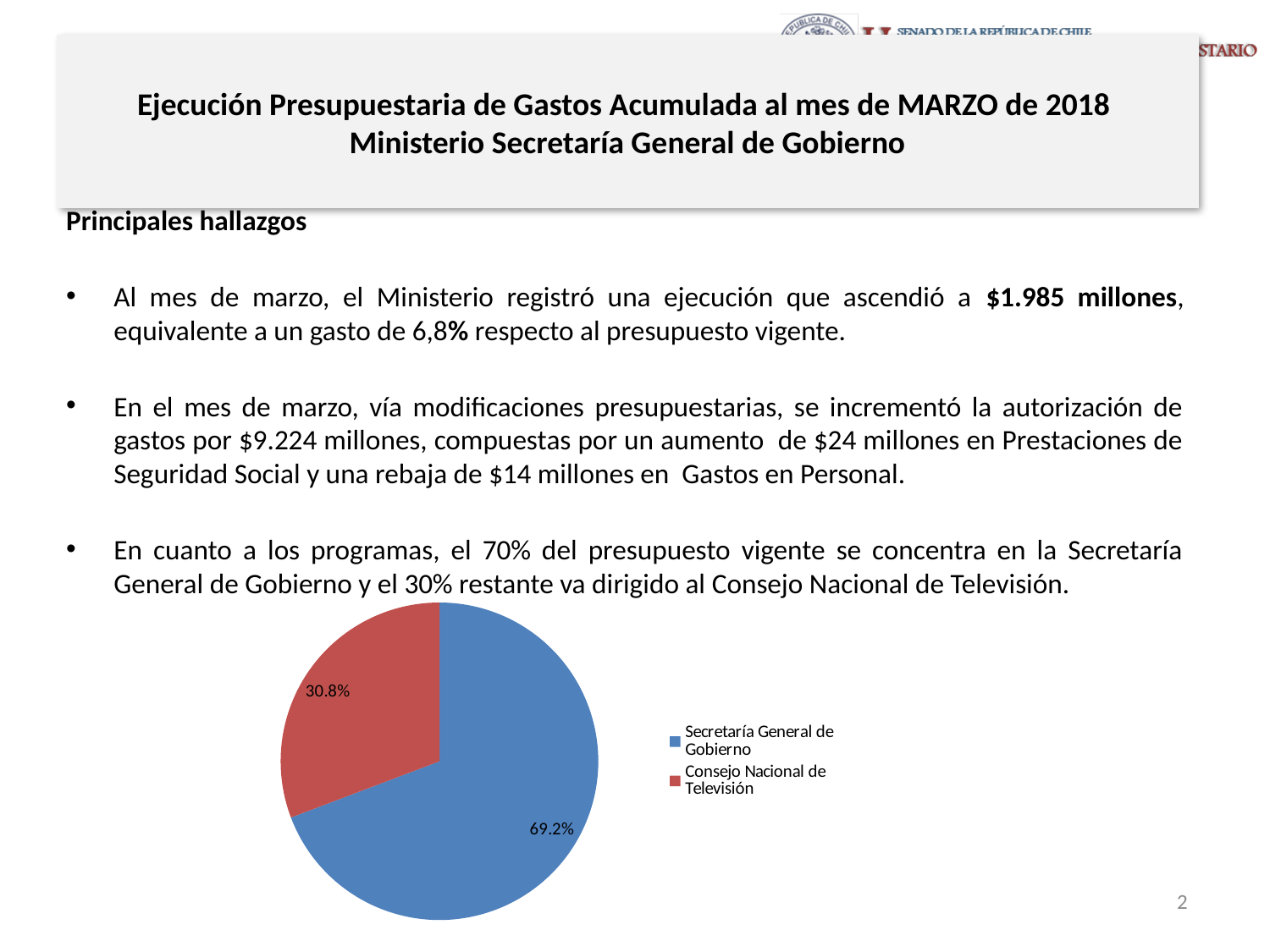
What colour is the slice for Secretaría General de Gobierno? Blue What share of the pie does Consejo Nacional de Televisión have? 30.8% Which is larger: the share for Secretaría General de Gobierno or the share for Consejo Nacional de Televisión? Secretaría General de Gobierno What kind of chart is shown on the slide? Pie chart What is the difference in percentage points between the Secretaría General de Gobierno slice and the Consejo Nacional de Televisión slice? 38.4 percentage points What colour is the slice for Consejo Nacional de Televisión? Red How many entries does the legend list? 2 Which slice of the pie is the largest? Secretaría General de Gobierno Which slice of the pie is the smallest? Consejo Nacional de Televisión How many slices does the pie chart have? 2 What share of the pie does Secretaría General de Gobierno have? 69.2%